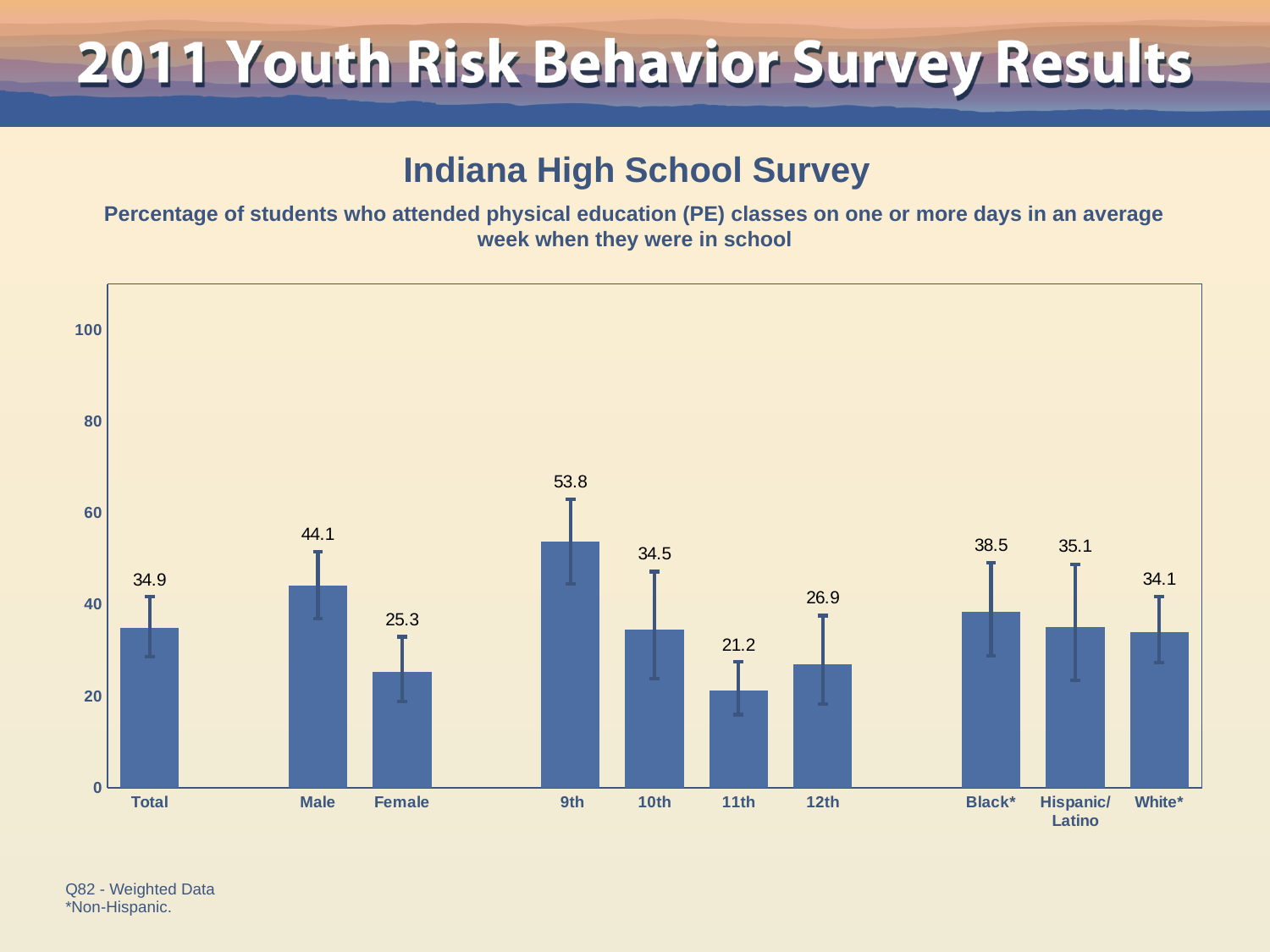
What is the difference between the Male and Female values? 18.8 What is the value for Hispanic/Latino students? 35.1 Which category has the lowest value? 11th What kind of chart is this? bar chart Do the values rise or fall from 9th grade to 11th grade? fall Which is larger, the value for Black* or the value for White*? Black* What is the value for Total? 34.9 Which category has the highest value? 9th Is the value for 9th grade greater or less than 40? greater How many categories are shown on the x axis? 10 What is the value for Male? 44.1 What is the value for 11th grade? 21.2